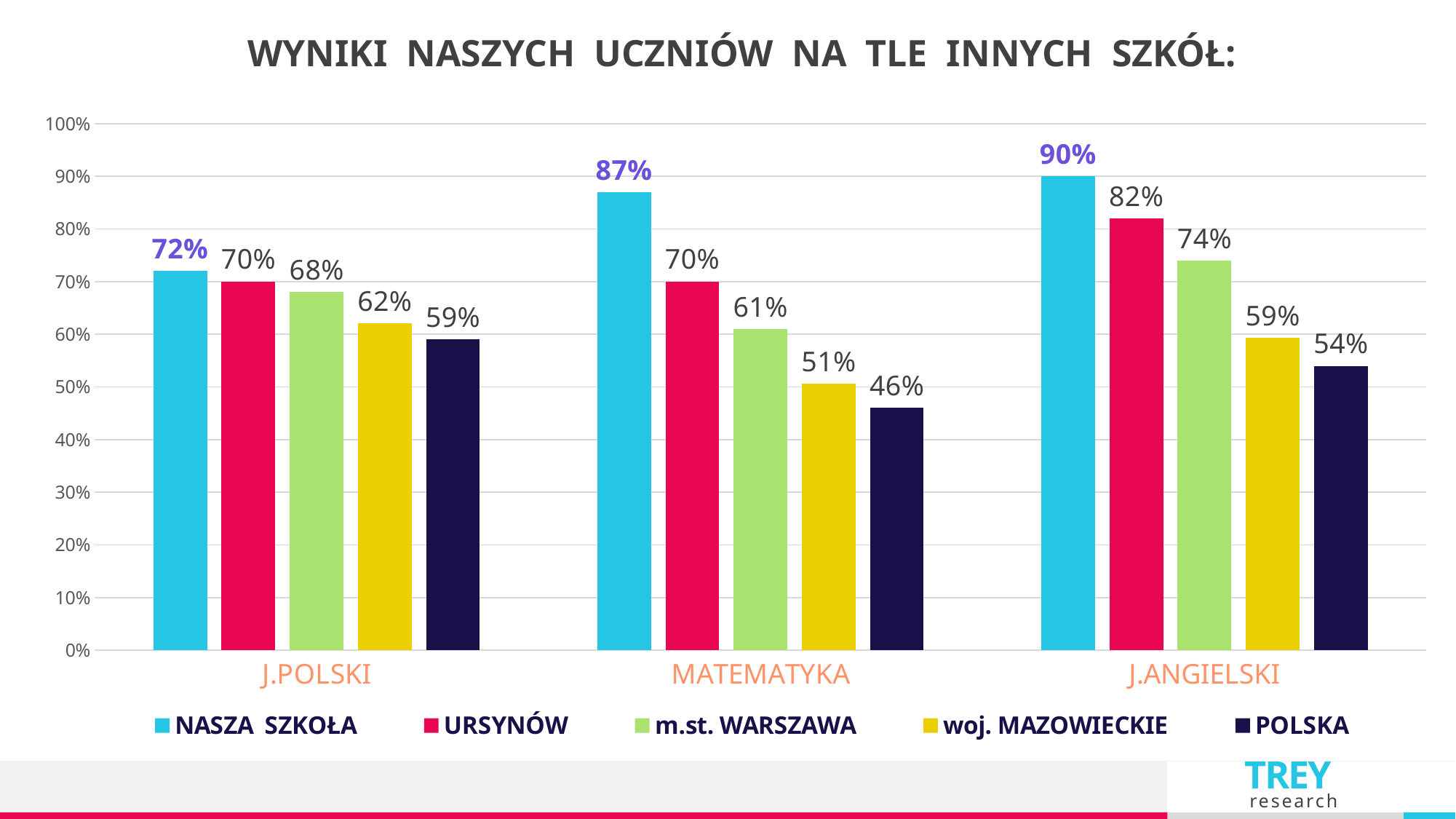
What kind of chart is shown on the slide? bar chart What is the title of the chart? WYNIKI NASZYCH UCZNIÓW NA TLE INNYCH SZKÓŁ: Which series has the lowest value in MATEMATYKA? POLSKA How many categories are shown on the x axis? 3 What is the difference between NASZA SZKOŁA and URSYNÓW in J.ANGIELSKI? 8% Is the value for POLSKA in MATEMATYKA greater or less than 50%? less What is the value for POLSKA in J.ANGIELSKI? 54% What is the value for woj. MAZOWIECKIE in J.POLSKI? 62% Which series has the highest value in J.ANGIELSKI? NASZA SZKOŁA What is the value for NASZA SZKOŁA in MATEMATYKA? 87% Which is larger: m.st. WARSZAWA in J.POLSKI or m.st. WARSZAWA in MATEMATYKA? m.st. WARSZAWA in J.POLSKI How many series does the legend list? 5